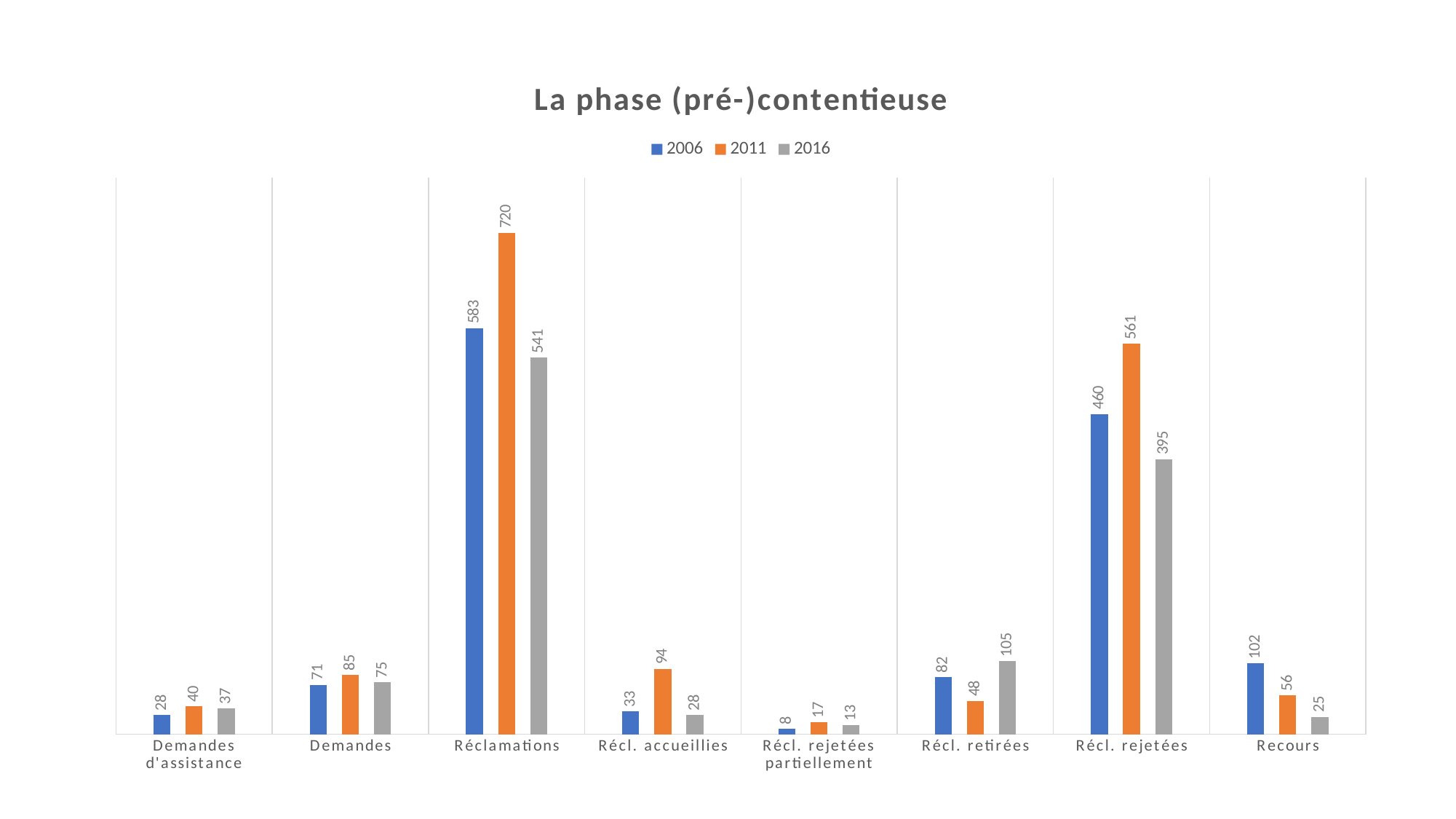
Which category has the lowest value for the 2006 series? Récl. rejetées partiellement How many series does the legend list? 3 Which is larger for Récl. accueillies: the 2006 value or the 2016 value? 2006 What is the value for Réclamations in 2011? 720 What kind of chart is shown on the slide? Bar chart What is the value for Récl. retirées in 2016? 105 What is the difference between the 2011 and 2016 values for Récl. rejetées? 166 What is the value for Recours in 2006? 102 Do the values for Recours rise or fall from 2006 to 2016? Fall How many categories are shown on the x axis? 8 Which category has the highest value for the 2016 series? Réclamations What is the title of the chart? La phase (pré-)contentieuse